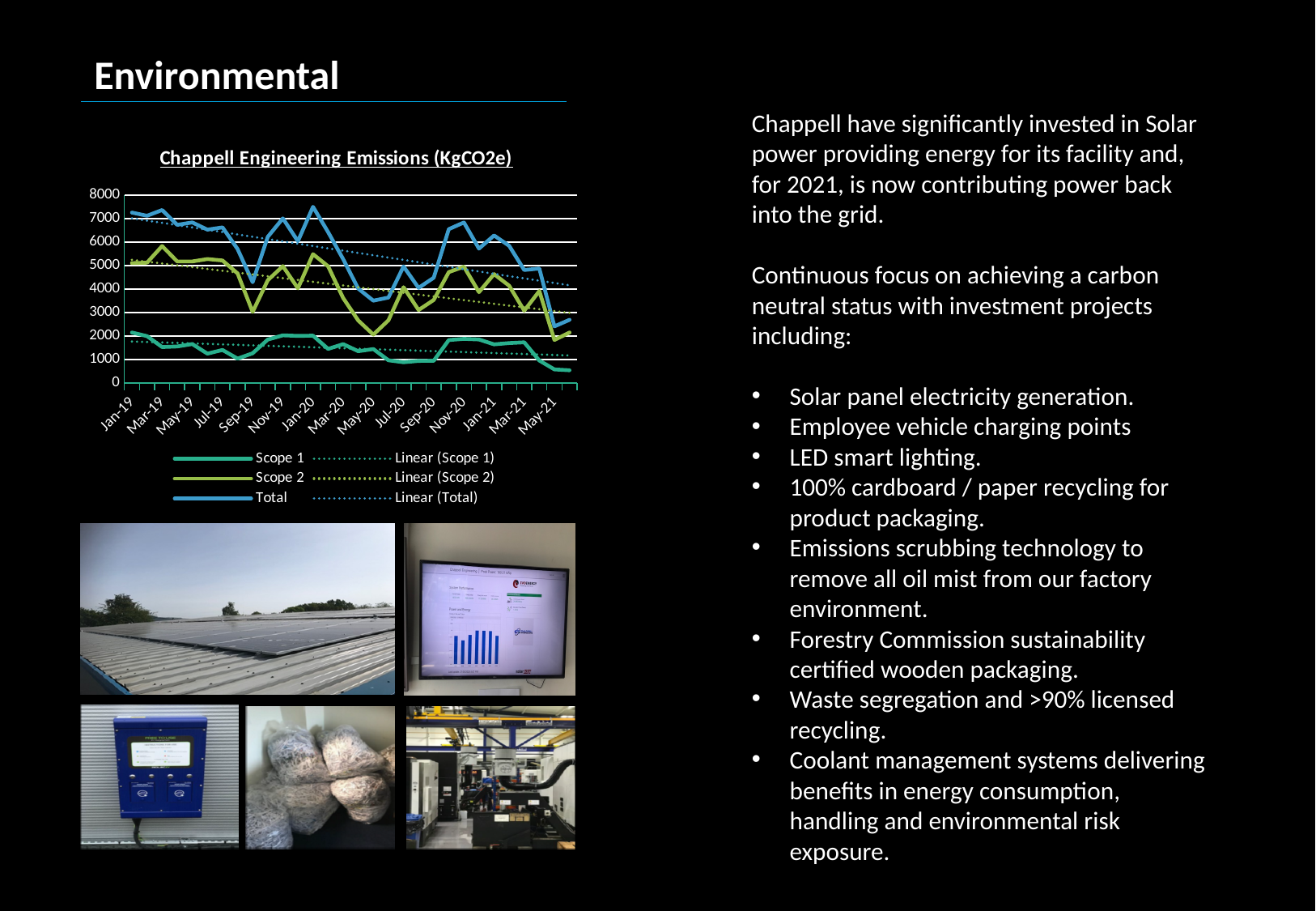
Which series has the highest values across the chart: Scope 1, Scope 2 or Total? Total Does the Total series rise or fall overall from Jan-19 to May-21? Fall Which series has the lowest values across the chart: Scope 1, Scope 2 or Total? Scope 1 Is the Scope 2 value for Jan-19 greater or less than 4000? greater Is the Scope 1 value for May-21 greater or less than 1000? less Is the Total value for Jan-19 greater or less than 6000? greater How many entries does the chart's legend list? 6 What is the title of the chart? Chappell Engineering Emissions (KgCO2e) What kind of chart is shown on the slide? Line chart How many month labels are shown along the x axis of the chart? 15